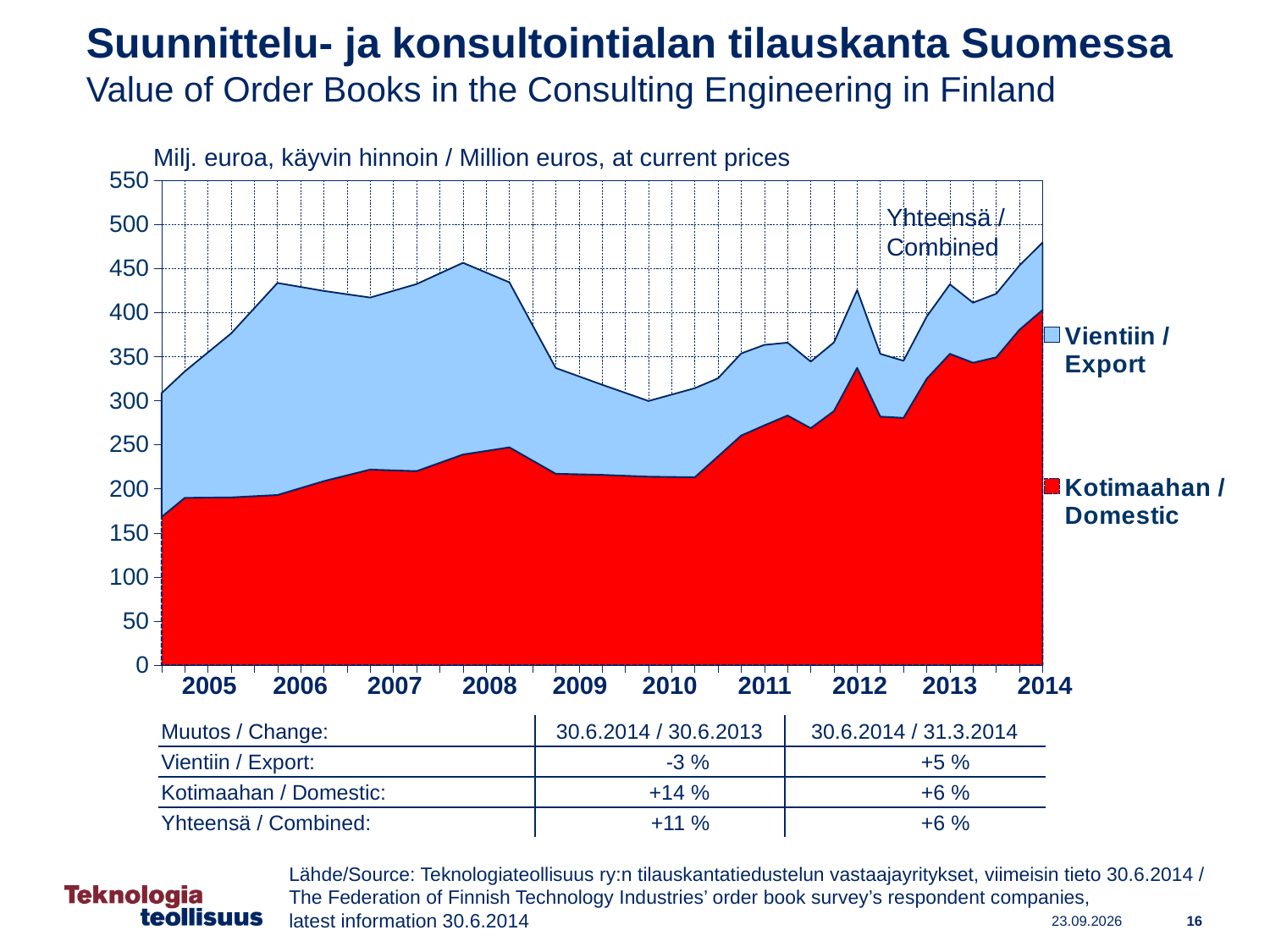
According to the change table below the chart, what is the change for Kotimaahan / Domestic for 30.6.2014 / 30.6.2013? +14 % How many series does the chart's legend list? 2 Does the combined (Yhteensä / Combined) value rise or fall from its 2008 peak to 2010? fall Does the Kotimaahan / Domestic series rise or fall overall from 2005 to 2014? rise Which series is drawn in red on the chart? Kotimaahan / Domestic How many year labels are shown on the x axis of the chart? 10 What kind of chart is shown on the slide? Stacked area chart What unit is stated above the chart for the plotted values? Milj. euroa, käyvin hinnoin / Million euros, at current prices Is the combined (Yhteensä / Combined) value at the start of 2005 greater or less than 350? less Is the combined (Yhteensä / Combined) value at the end of 2014 greater or less than 450? greater Is the Kotimaahan / Domestic value at the start of 2005 greater or less than 200? less